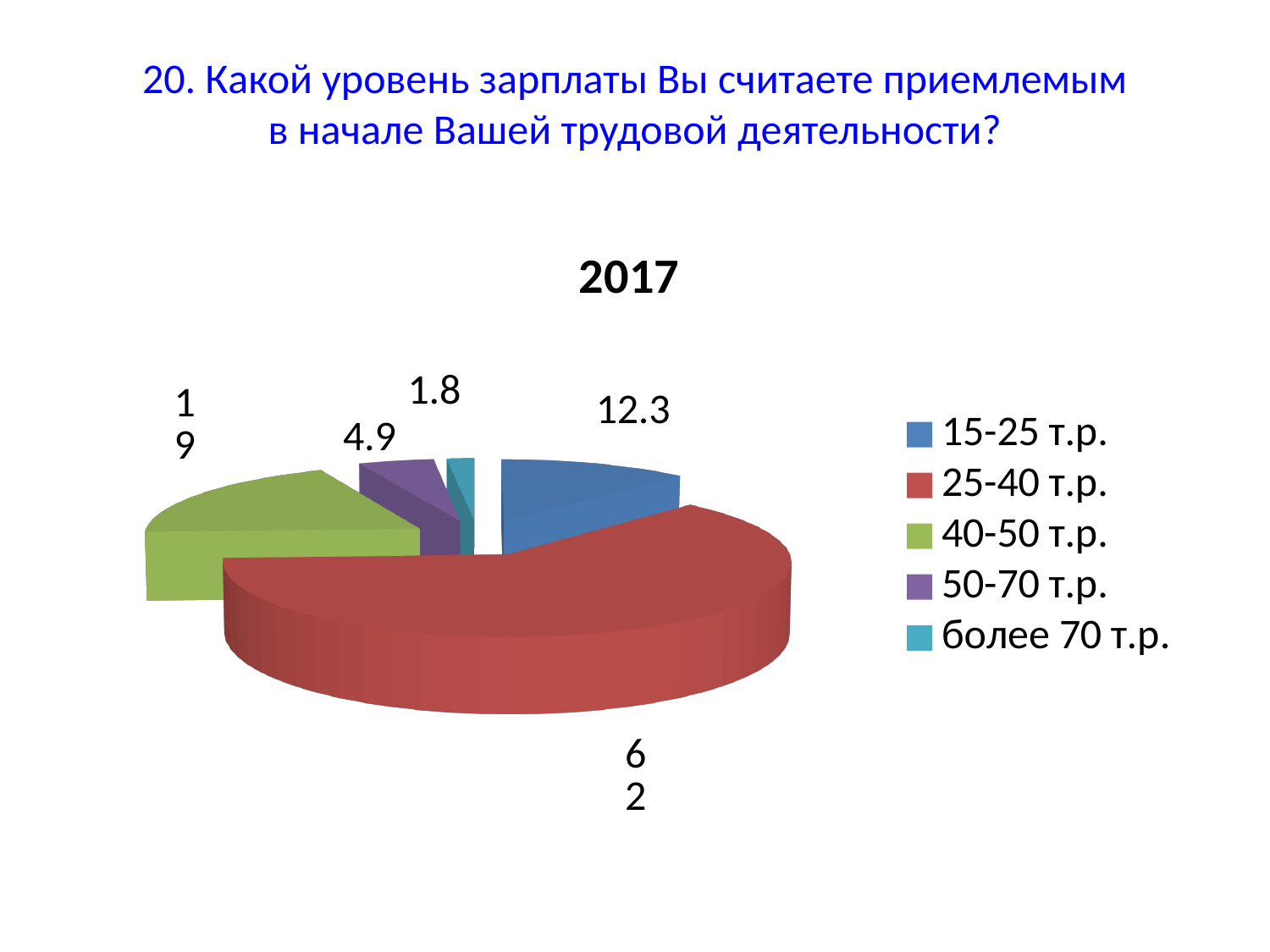
What is the value for the более 70 т.р. slice? 1.8 What is the value for the 15-25 т.р. slice? 12.3 Which category has the largest slice? 25-40 т.р. What is the difference between the 15-25 т.р. value and the 50-70 т.р. value? 7.4 What is the value for the 50-70 т.р. slice? 4.9 What is the value for the 25-40 т.р. slice? 62 Which category has the smallest slice? более 70 т.р. What kind of chart is shown on the slide? pie chart Which is larger, the 15-25 т.р. slice or the 50-70 т.р. slice? 15-25 т.р. How many categories does the legend list? 5 What is the title of the chart? 2017 What is the value for the 40-50 т.р. slice? 19